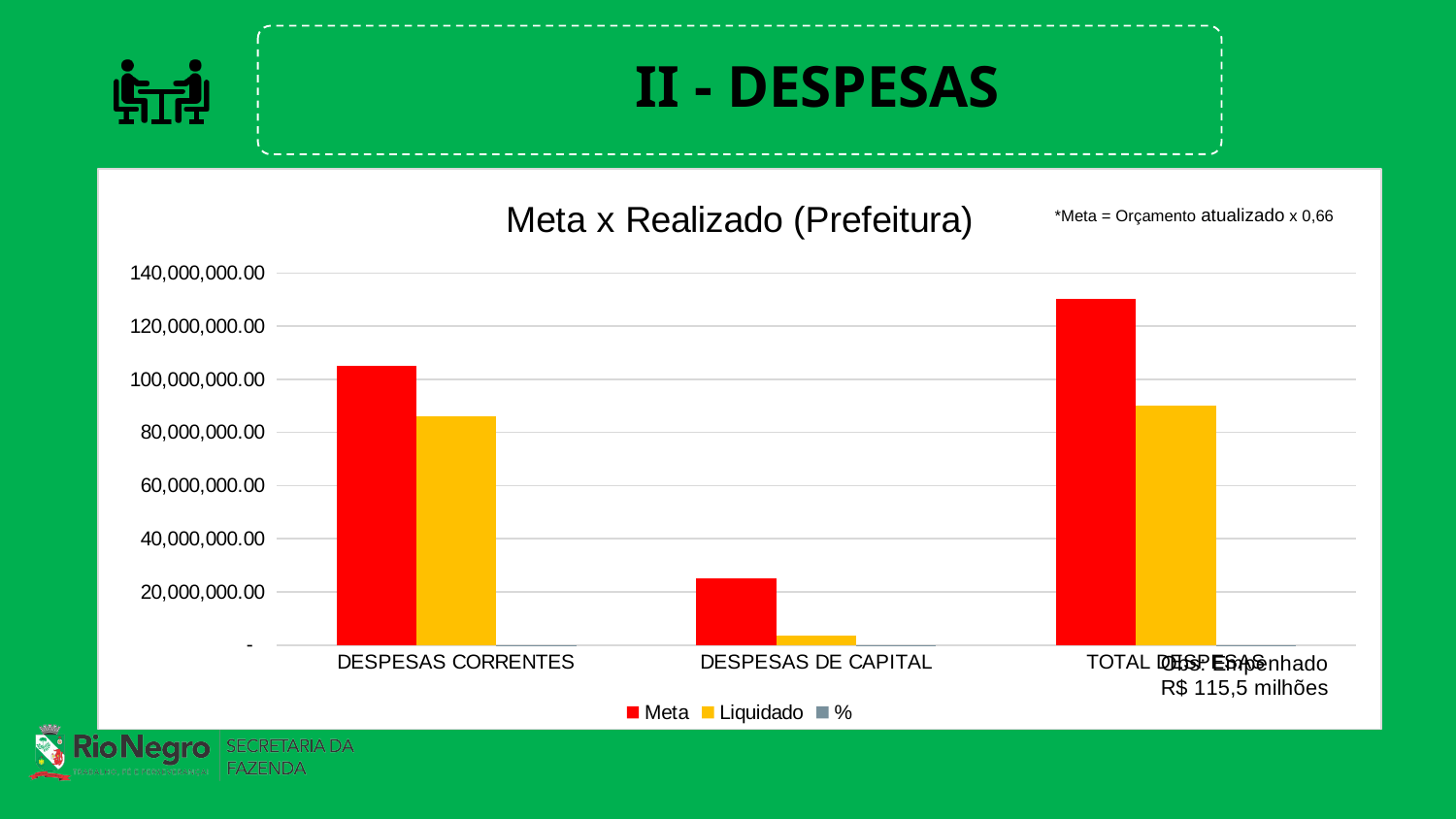
What is the title of the chart? Meta x Realizado (Prefeitura) For DESPESAS CORRENTES, which is larger, Meta or Liquidado? Meta How many series does the chart legend list? 3 Which category has the lowest Meta value? DESPESAS DE CAPITAL Is the Meta value for TOTAL DESPESAS greater or less than 120,000,000.00? greater How many categories are shown on the x axis of the chart? 3 What type of chart is shown on the slide? bar chart Which category has the highest Meta value? TOTAL DESPESAS Is the Meta value for DESPESAS CORRENTES greater or less than 100,000,000.00? greater Is the Liquidado value for DESPESAS DE CAPITAL greater or less than 20,000,000.00? less What colour represents the Meta series in the chart? red